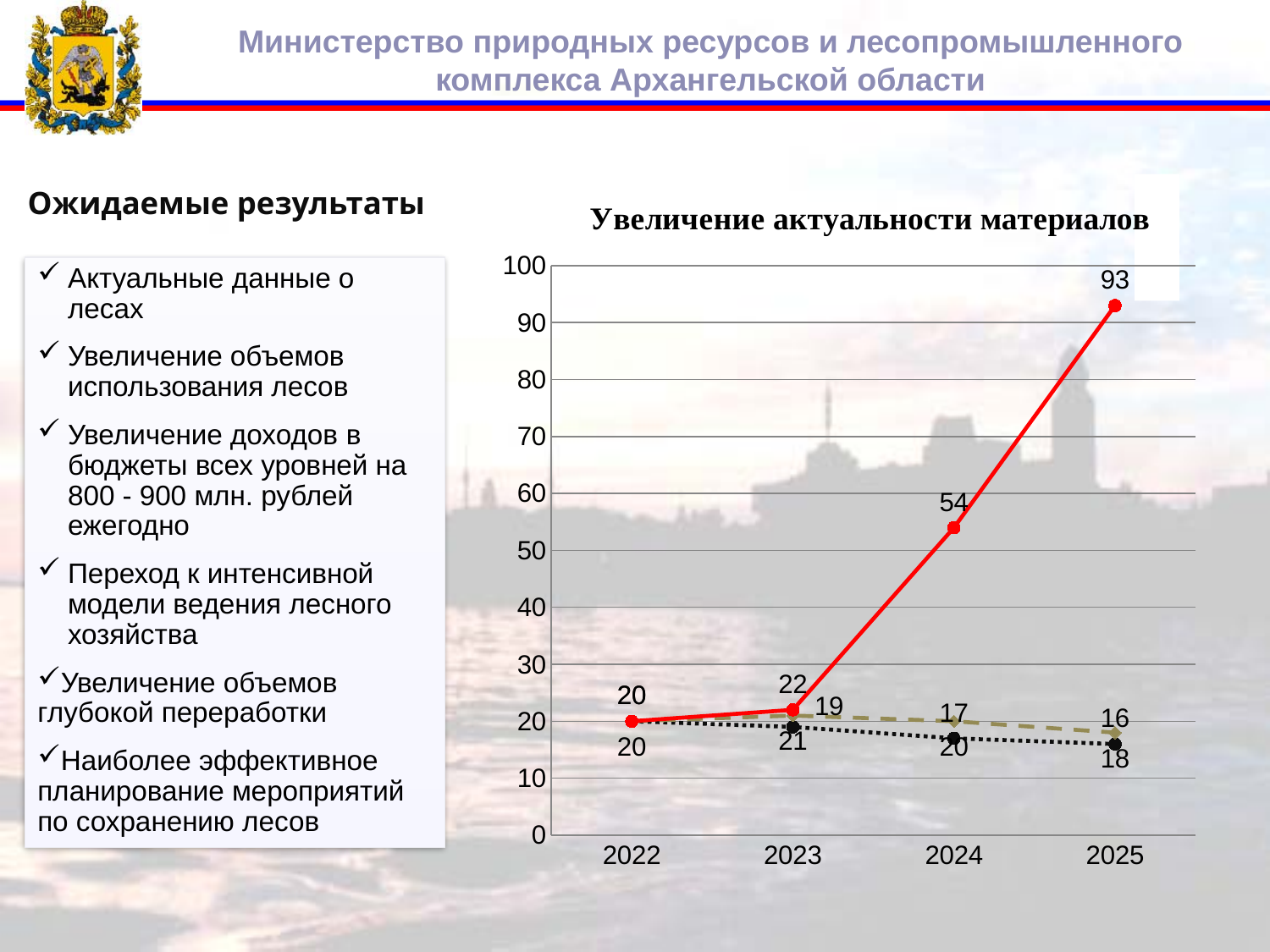
In which year does the red line reach its highest value? 2025 What is the value of the dashed line in 2025? 18 What is the value of the black dotted line in 2025? 16 What is the difference between the red line's values in 2025 and 2024? 39 What is the value of the red line in 2025? 93 Does the red line rise or fall from 2022 to 2025? rise What type of chart is shown on the slide? line chart How many years are shown on the x axis of the chart? 4 What is the value of the red line in 2023? 22 What is the title of the chart? Увеличение актуальности материалов What is the value of the red line in 2024? 54 Is the value of the red line in 2024 greater or less than 50? greater